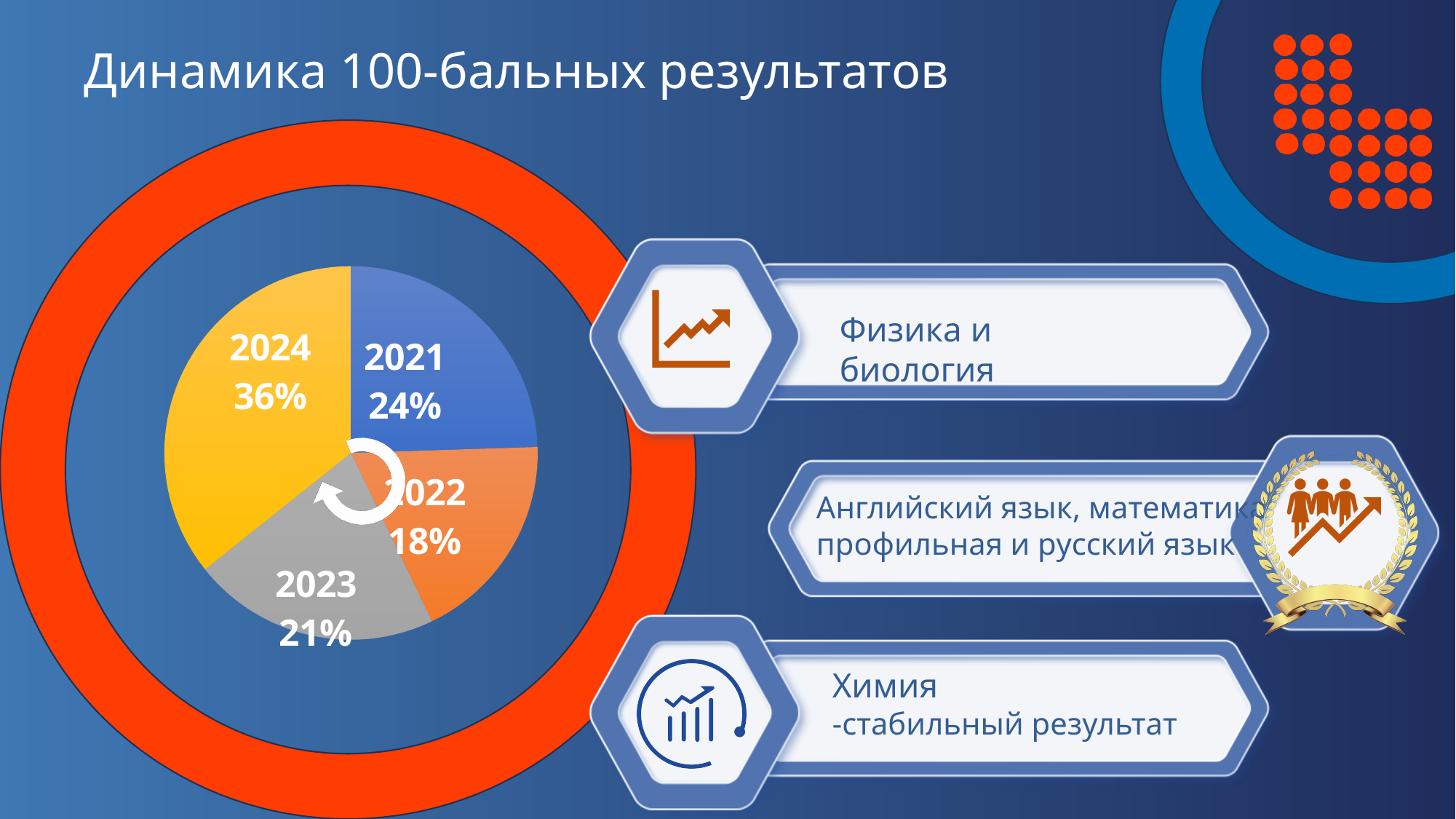
How many slices does the pie chart have? 4 What is the difference between the shares for 2023 and 2022? 3% What is the value shown for 2022? 18% Which year has the smallest slice of the pie? 2022 What is the difference between the shares for 2024 and 2021? 12% What share of the pie does 2021 have? 24% What share of the pie does 2024 have? 36% What kind of chart is shown on the slide? pie chart Which year has the largest slice of the pie? 2024 What is the title of the slide containing the pie chart? Динамика 100-бальных результатов What is the value shown for 2023? 21% Which is larger, the share for 2021 or the share for 2023? 2021